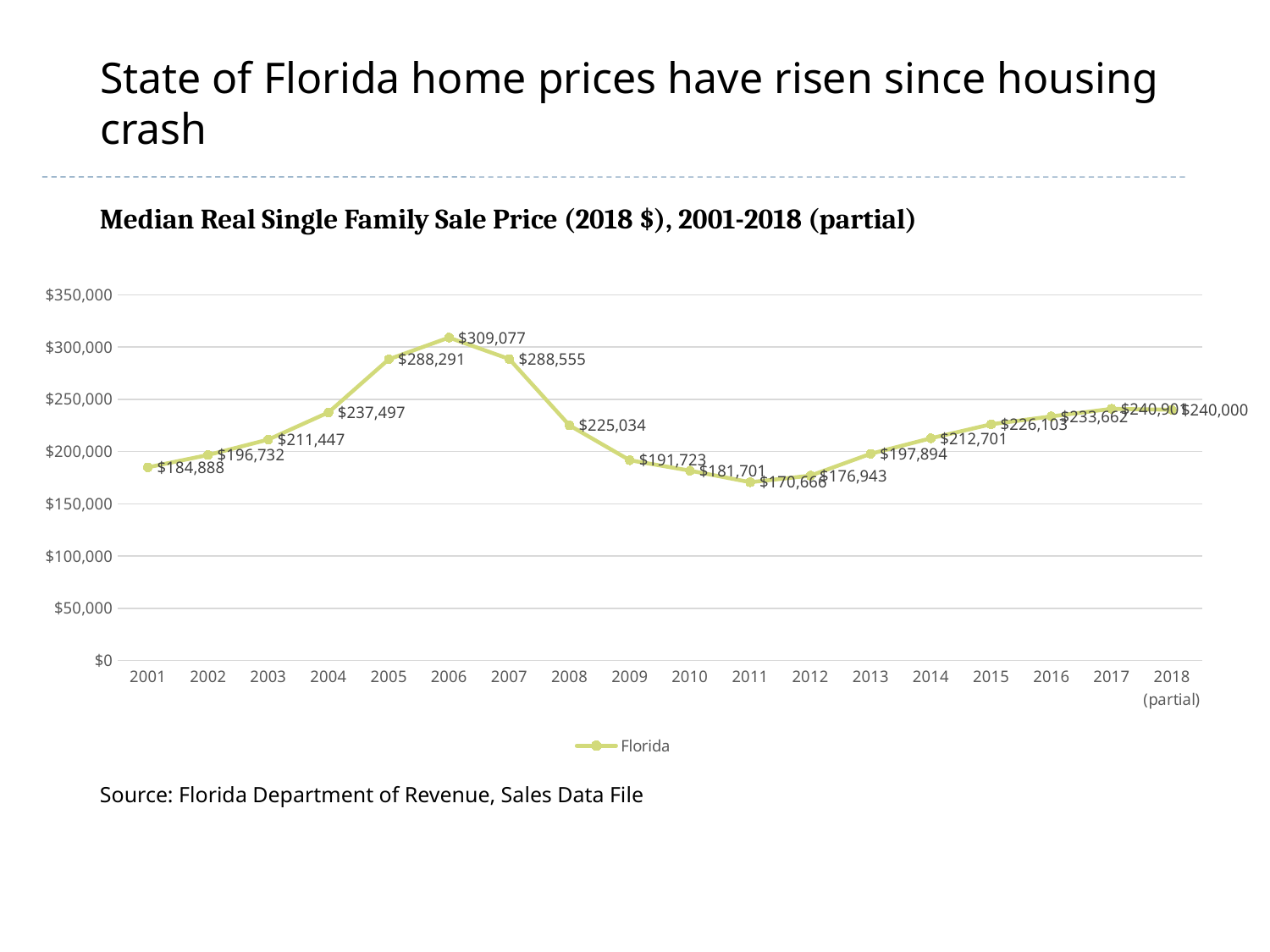
What value is shown for 2018 (partial)? $240,000 How many years are plotted on the x axis? 18 What is the difference between the 2008 and 2009 median sale prices? $33,311 Which year has the highest median sale price? 2006 What was the median real single family sale price in Florida in 2001? $184,888 What was the median real single family sale price in Florida in 2006? $309,077 What kind of chart is shown on the slide? line chart Which year had a higher median sale price, 2004 or 2008? 2004 Which year has the lowest median sale price? 2011 Is the median sale price for 2011 greater or less than $200,000? less What was the median sale price in 2013? $197,894 How much higher was the median sale price in 2006 than in 2001? $124,189